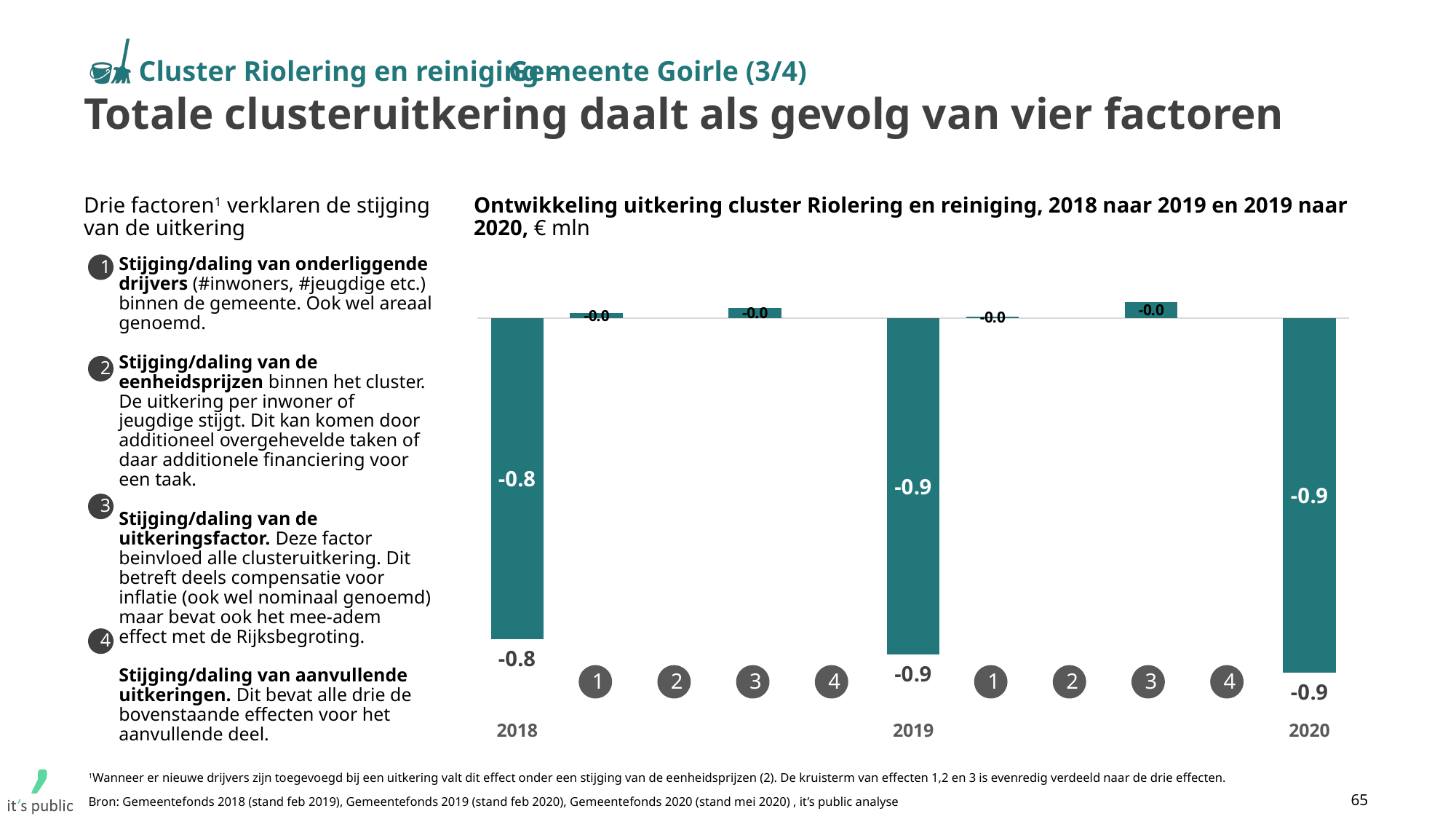
Does the total uitkering rise or fall from 2018 to 2020? Fall What is the difference between the 2018 value and the 2019 value? 0.1 What is the value of the 2018 bar in the chart? -0.8 How many numbered factor steps are shown between 2018 and 2019? 4 In what unit are the chart values expressed? € mln What kind of chart is shown on the slide? Bar chart What is the title of the chart? Ontwikkeling uitkering cluster Riolering en reiniging, 2018 naar 2019 en 2019 naar 2020, € mln What is the value of the 2019 bar in the chart? -0.9 Which year has the highest (least negative) value: 2018, 2019 or 2020? 2018 What is the value of the 2020 bar in the chart? -0.9 Which is larger, the value for 2018 or the value for 2019? 2018 How many year totals (2018, 2019, 2020) are shown in the chart? 3